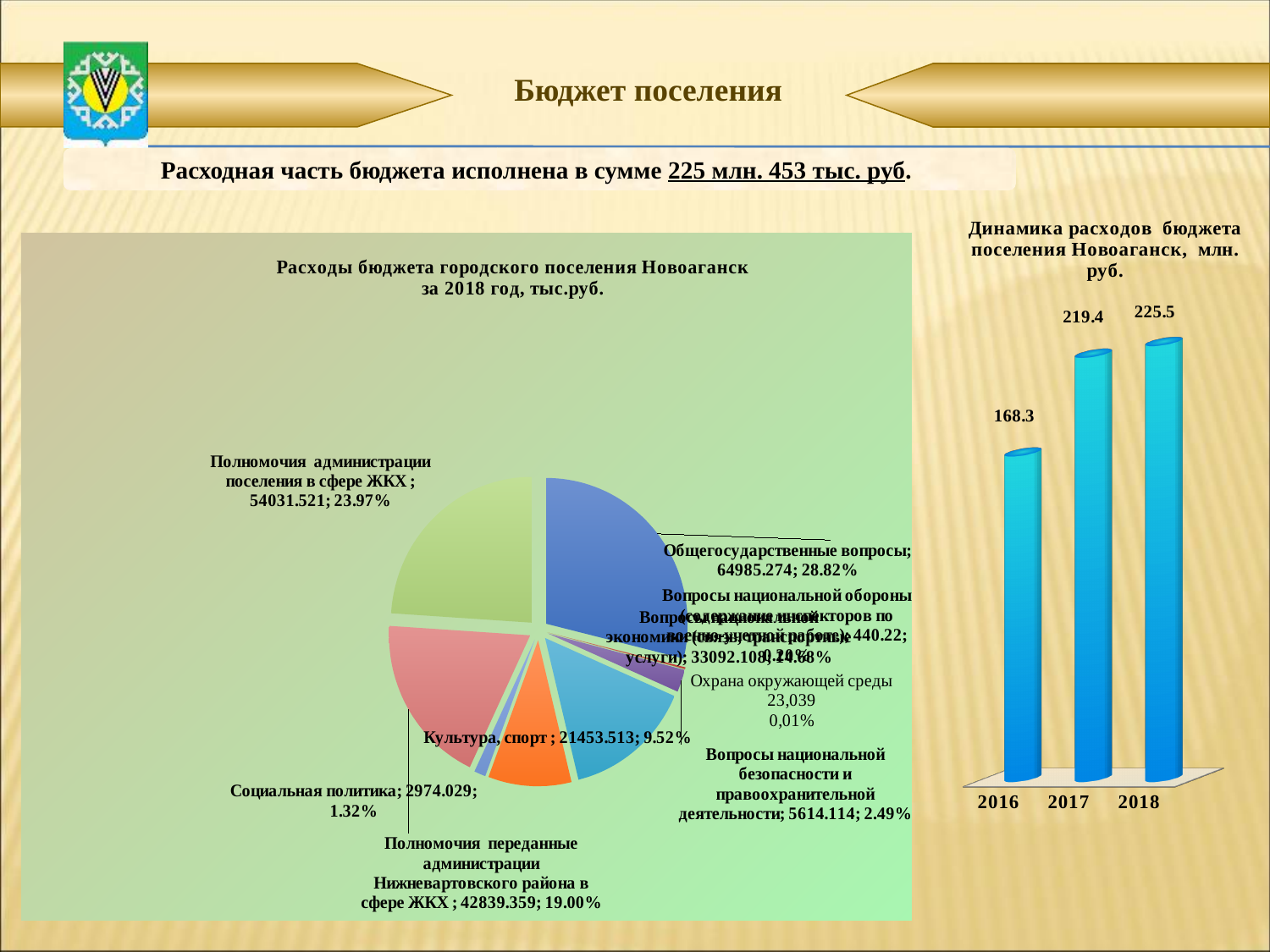
In the pie chart on the left, what is the value for 'Культура, спорт'? 21453.513 In the pie chart on the left, which category has the largest slice? Общегосударственные вопросы In the bar chart on the right, which year has the highest value? 2018 In the pie chart on the left, which is larger: 'Социальная политика' or 'Вопросы национальной безопасности и правоохранительной деятельности'? Вопросы национальной безопасности и правоохранительной деятельности In the bar chart on the right, what is the difference between the values for 2018 and 2016? 57.2 What kind of chart is the chart on the right of the slide? bar chart In the pie chart 'Расходы бюджета городского поселения Новоаганск за 2018 год', what share does 'Общегосударственные вопросы' have? 28.82% In the bar chart on the right, which year has the lowest value? 2016 In the bar chart 'Динамика расходов бюджета поселения Новоаганск, млн. руб.', what is the value for 2018? 225.5 In the bar chart 'Динамика расходов бюджета поселения Новоаганск, млн. руб.', what is the value for 2016? 168.3 How many years are shown in the bar chart on the right? 3 In the bar chart on the right, do the values rise or fall from 2016 to 2018? rise